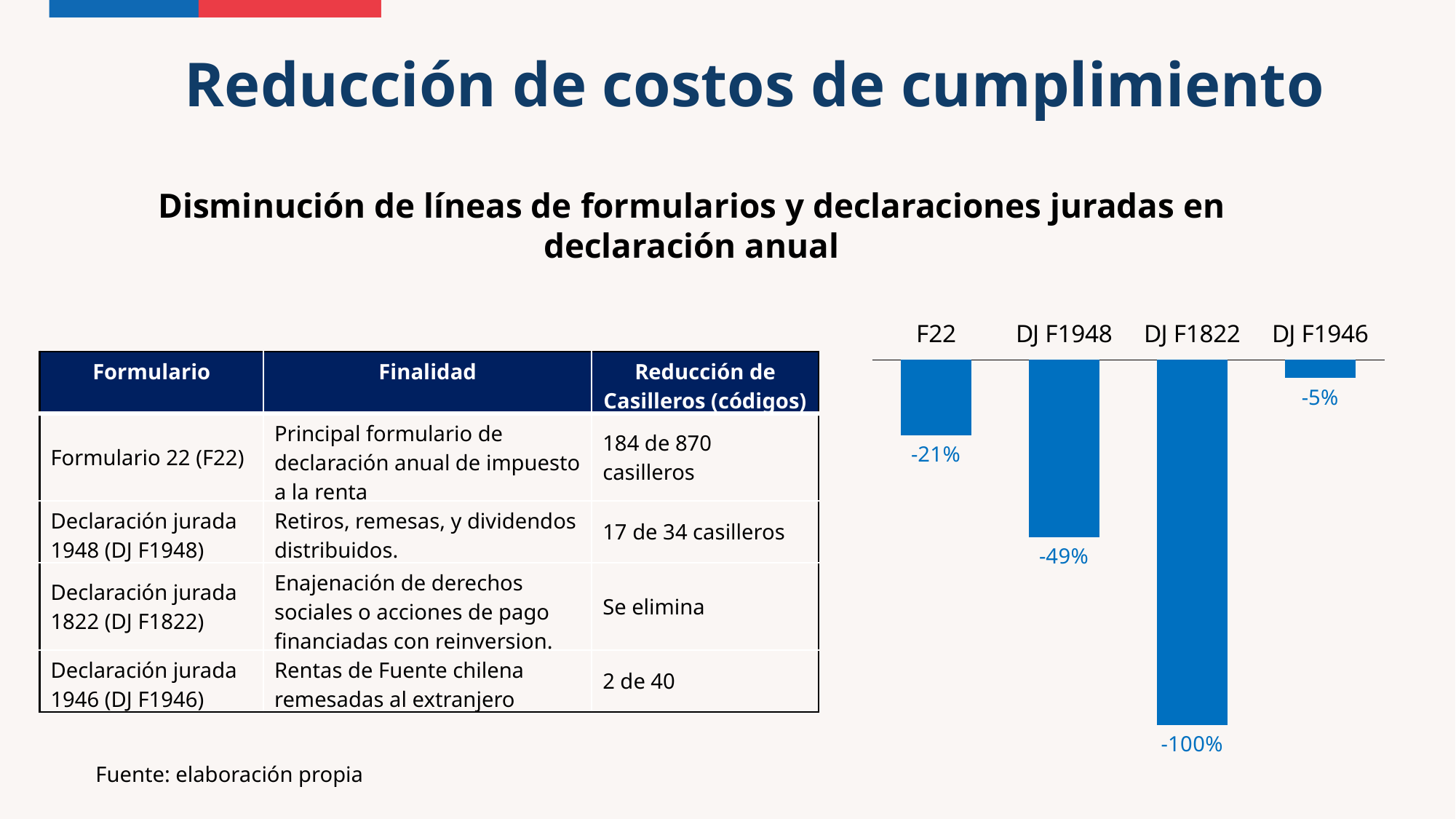
Which category in the bar chart shows the largest reduction (most negative value)? DJ F1822 What value is shown for F22 in the bar chart? -21% What value is shown for DJ F1822 in the bar chart? -100% What type of chart is shown on the right side of the slide? Bar chart What is the difference in percentage points between the values for F22 and DJ F1946? 16 percentage points Which category in the bar chart shows the smallest reduction (value closest to zero)? DJ F1946 What is the difference in percentage points between the values for DJ F1822 and DJ F1948? 51 percentage points What colour are the bars in the chart? Blue How many categories are plotted in the bar chart? 4 What value is shown for DJ F1948 in the bar chart? -49% What value is shown for DJ F1946 in the bar chart? -5% Which has a larger reduction in the bar chart, F22 or DJ F1948? DJ F1948